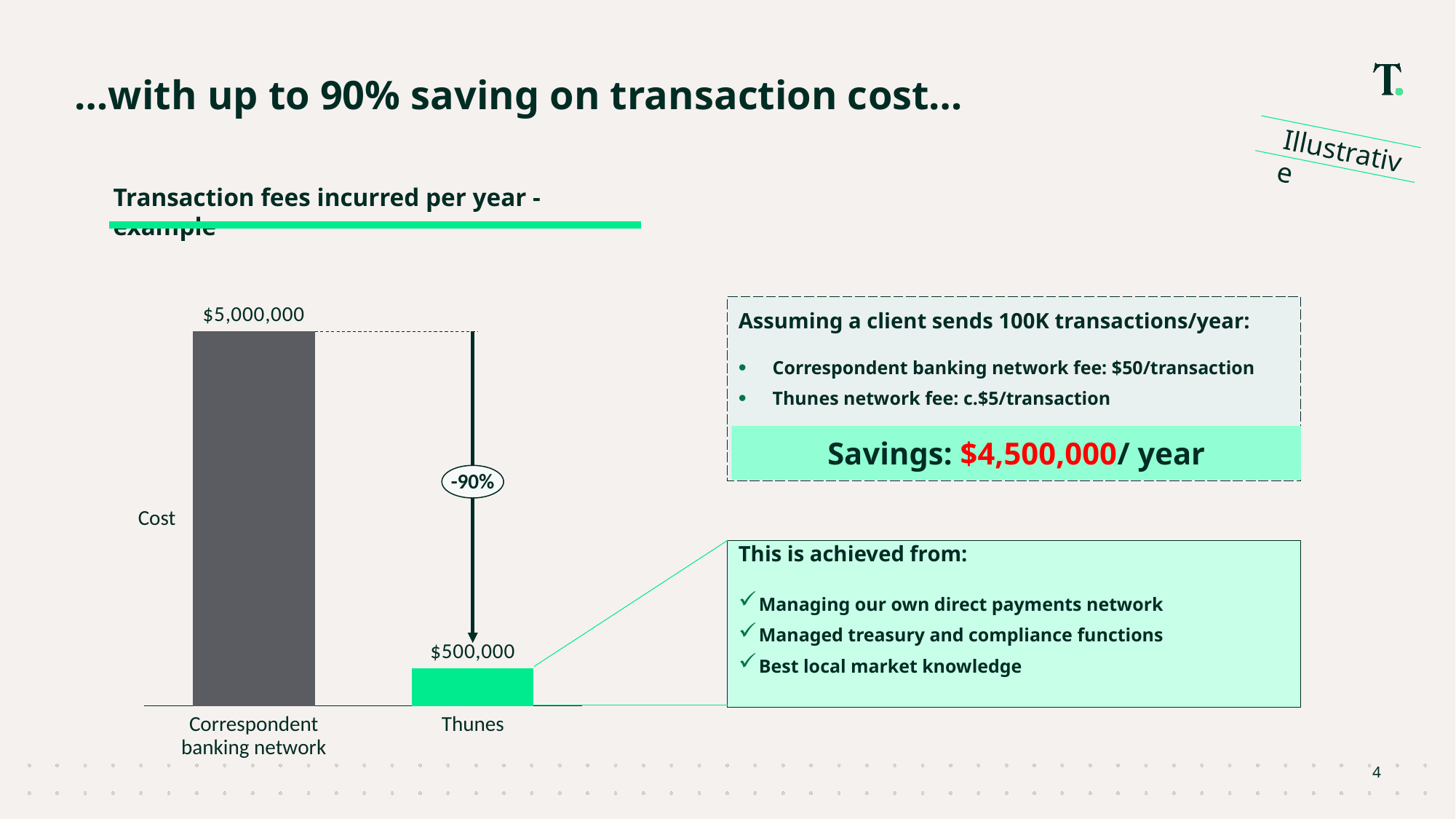
What is the transaction fee per year for Thunes? $500,000 What is the difference between the Correspondent banking network fee and the Thunes fee per year? $4,500,000 What is the title of the chart? Transaction fees incurred per year - example What is the transaction fee per year for the Correspondent banking network? $5,000,000 How many categories are shown in the chart? 2 What percentage reduction is labelled on the arrow between the two bars? -90% What kind of chart is shown on the slide? Bar chart Which is larger, the fee for the Correspondent banking network or the fee for Thunes? Correspondent banking network Which category has the highest transaction fees per year? Correspondent banking network Do the values fall or rise from the Correspondent banking network bar to the Thunes bar? Fall Which category has the lowest transaction fees per year? Thunes